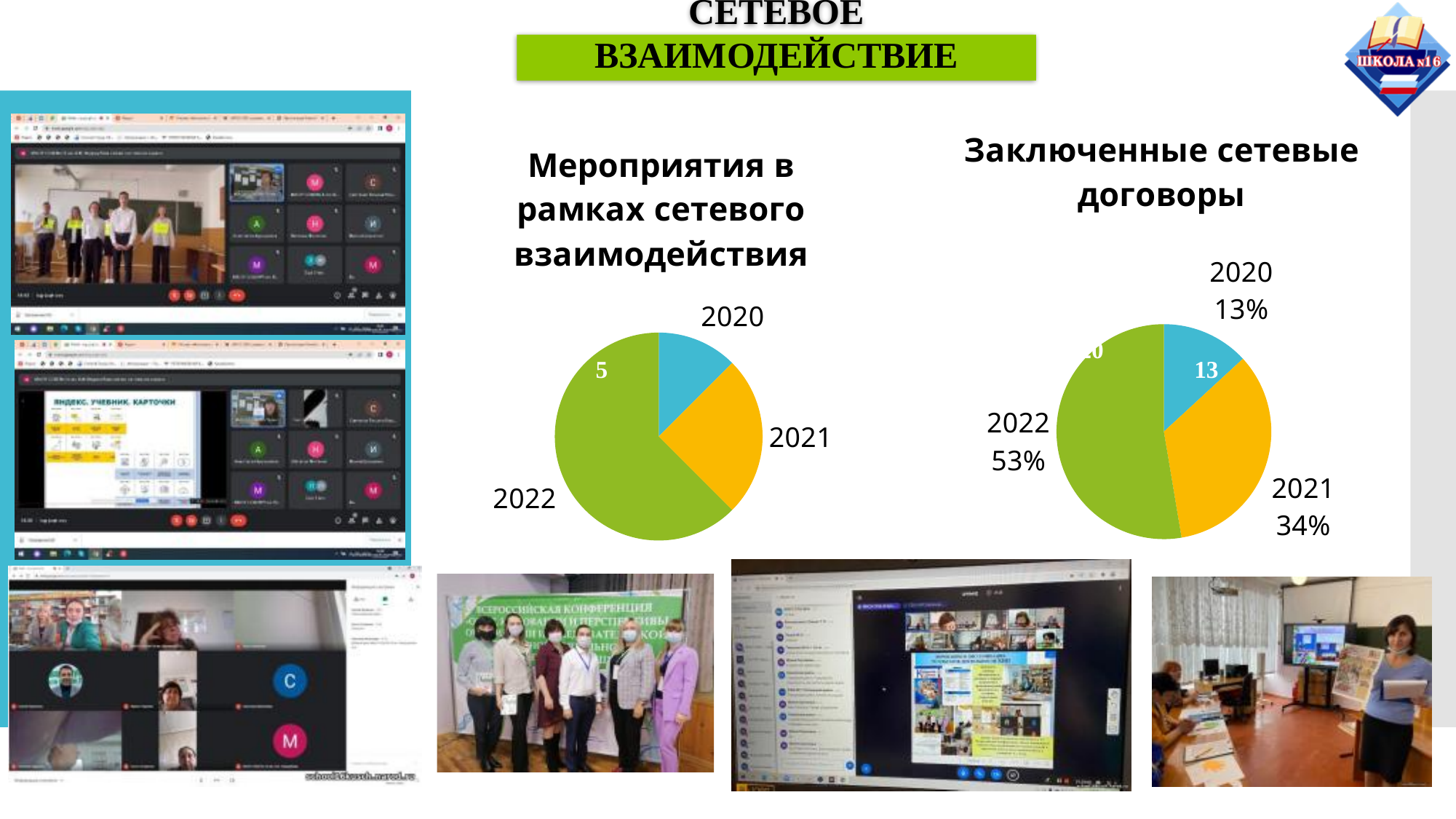
In the 'Мероприятия в рамках сетевого взаимодействия' chart, which slice is larger, 2020 or 2021? 2021 In the 'Заключенные сетевые договоры' chart, what colour is the 2020 slice? blue In the 'Заключенные сетевые договоры' chart, which year has the smallest slice? 2020 In the 'Заключенные сетевые договоры' chart, what is the difference in percentage points between the 2022 and 2021 shares? 19 In the 'Заключенные сетевые договоры' chart, what share does 2022 have? 53% How many slices does the 'Мероприятия в рамках сетевого взаимодействия' pie chart have? 3 In the 'Заключенные сетевые договоры' chart, what share does 2020 have? 13% In the 'Заключенные сетевые договоры' chart, which year has the largest slice? 2022 In the 'Мероприятия в рамках сетевого взаимодействия' chart, which year has the largest slice? 2022 What kind of chart is the 'Заключенные сетевые договоры' chart? pie chart In the 'Заключенные сетевые договоры' chart, what share does 2021 have? 34% What kind of chart is the 'Мероприятия в рамках сетевого взаимодействия' chart? pie chart